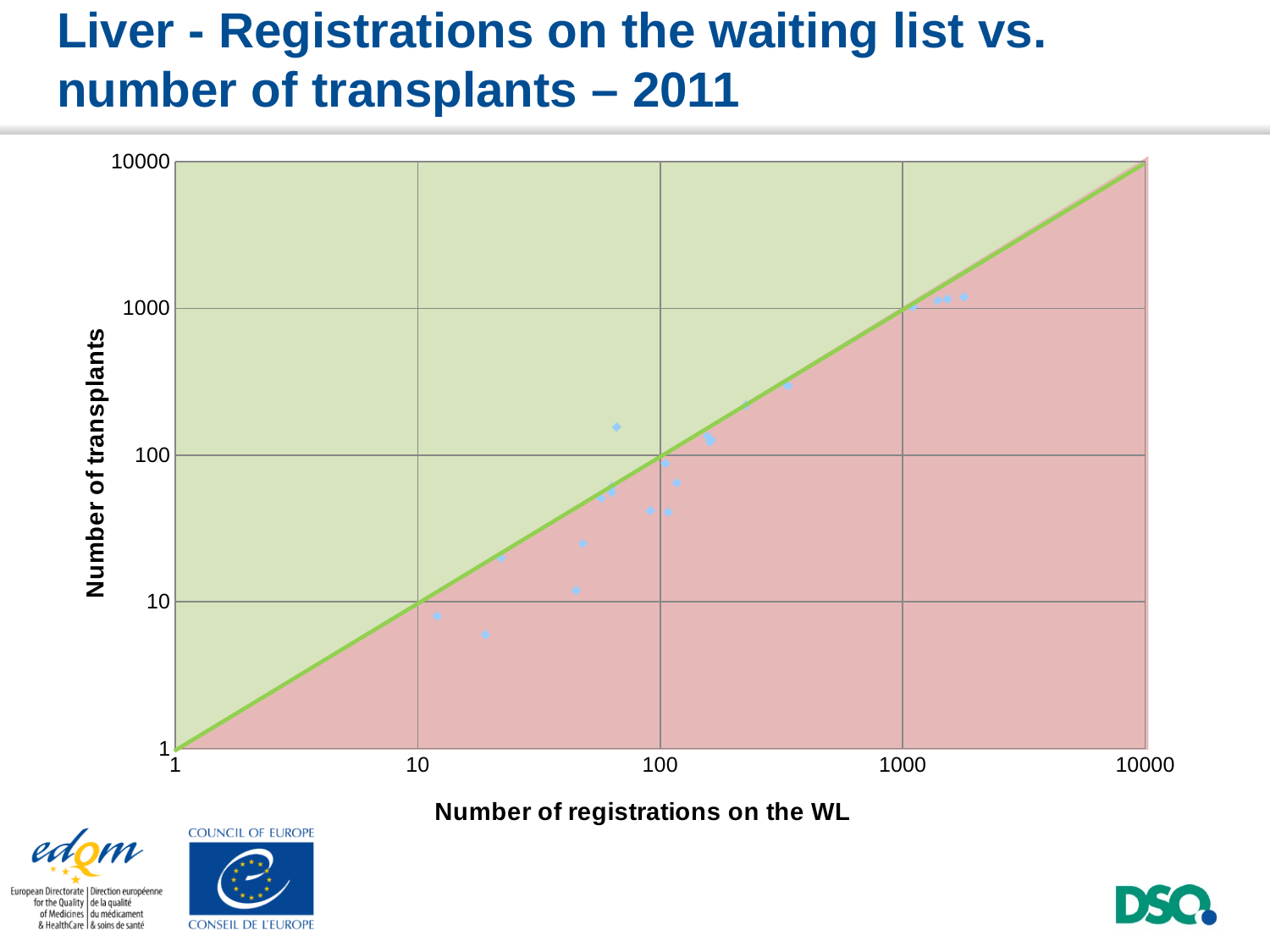
What kind of chart is shown on the slide? Scatter chart Are most of the plotted points above or below the green diagonal line? below Is the largest number of registrations on the WL plotted greater or less than 1000? greater What is the lowest tick value shown on the x axis? 1 Is the highest number of transplants plotted greater or less than 1000? greater Is the lowest number of transplants plotted greater or less than 10? less What is the highest tick value shown on the y axis? 10000 What is the label of the y axis? Number of transplants What is the title of the chart? Liver - Registrations on the waiting list vs. number of transplants – 2011 What is the label of the x axis? Number of registrations on the WL Do the numbers of transplants generally rise or fall as the number of registrations on the WL increases? rise